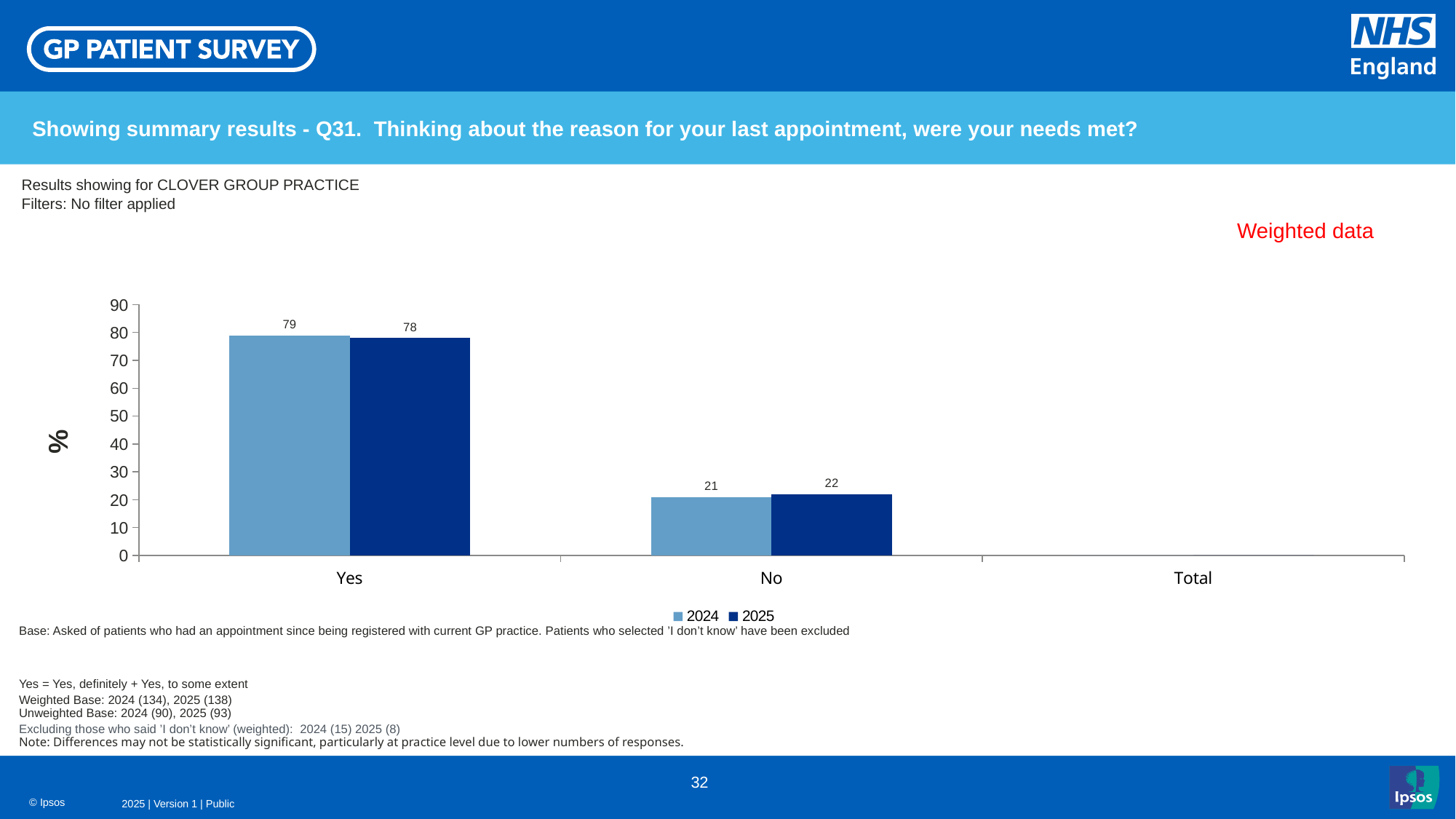
How many series does the legend list? 2 What kind of chart is shown on the slide? Bar chart What is the value for No in 2025? 22 Which category has the highest value in 2025? Yes Which category has the lowest value in 2024? No What is the value for Yes in 2025? 78 What is the difference between the Yes and No values in 2025? 56 Is the value for No in 2025 greater or less than 30? less What is the value for Yes in 2024? 79 What is the value for No in 2024? 21 What is the difference between the Yes values for 2024 and 2025? 1 Which is larger, the 2024 value for Yes or the 2024 value for No? 2024 value for Yes